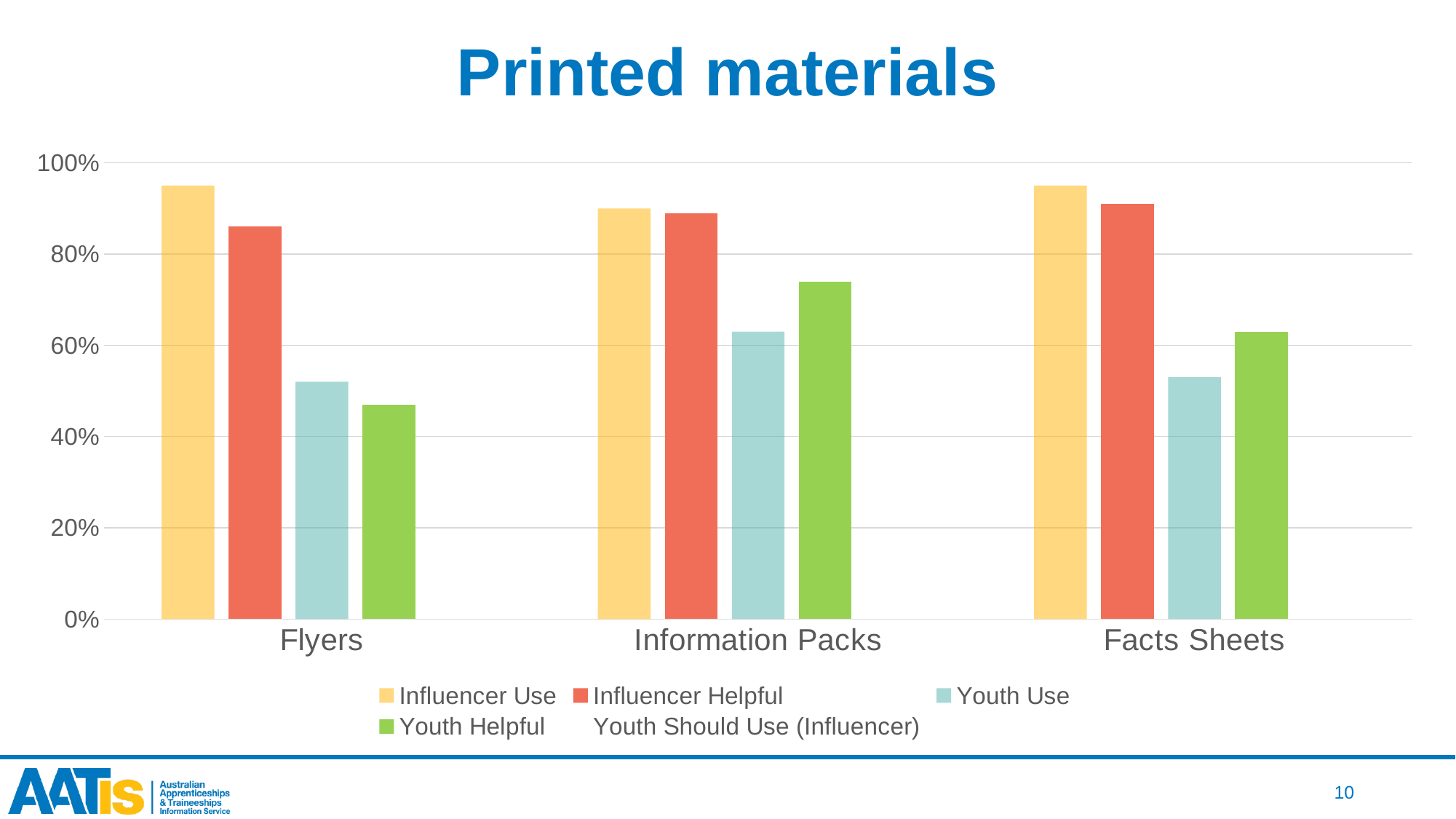
What is the title of the chart? Printed materials Which is larger: Youth Helpful for Information Packs or Youth Helpful for Flyers? Information Packs Is the value for Youth Helpful in the Information Packs category greater or less than 80%? less Which series has the highest value in the Flyers category? Influencer Use Is the value for Youth Use in the Facts Sheets category greater or less than 60%? less Which series has the lowest value in the Information Packs category? Youth Use How many categories are shown on the x axis? 3 Is the value for Youth Helpful in the Flyers category greater or less than 60%? less How many series does the legend list? 5 What kind of chart is shown on the slide? Bar chart Which colour represents the Influencer Helpful series? Red